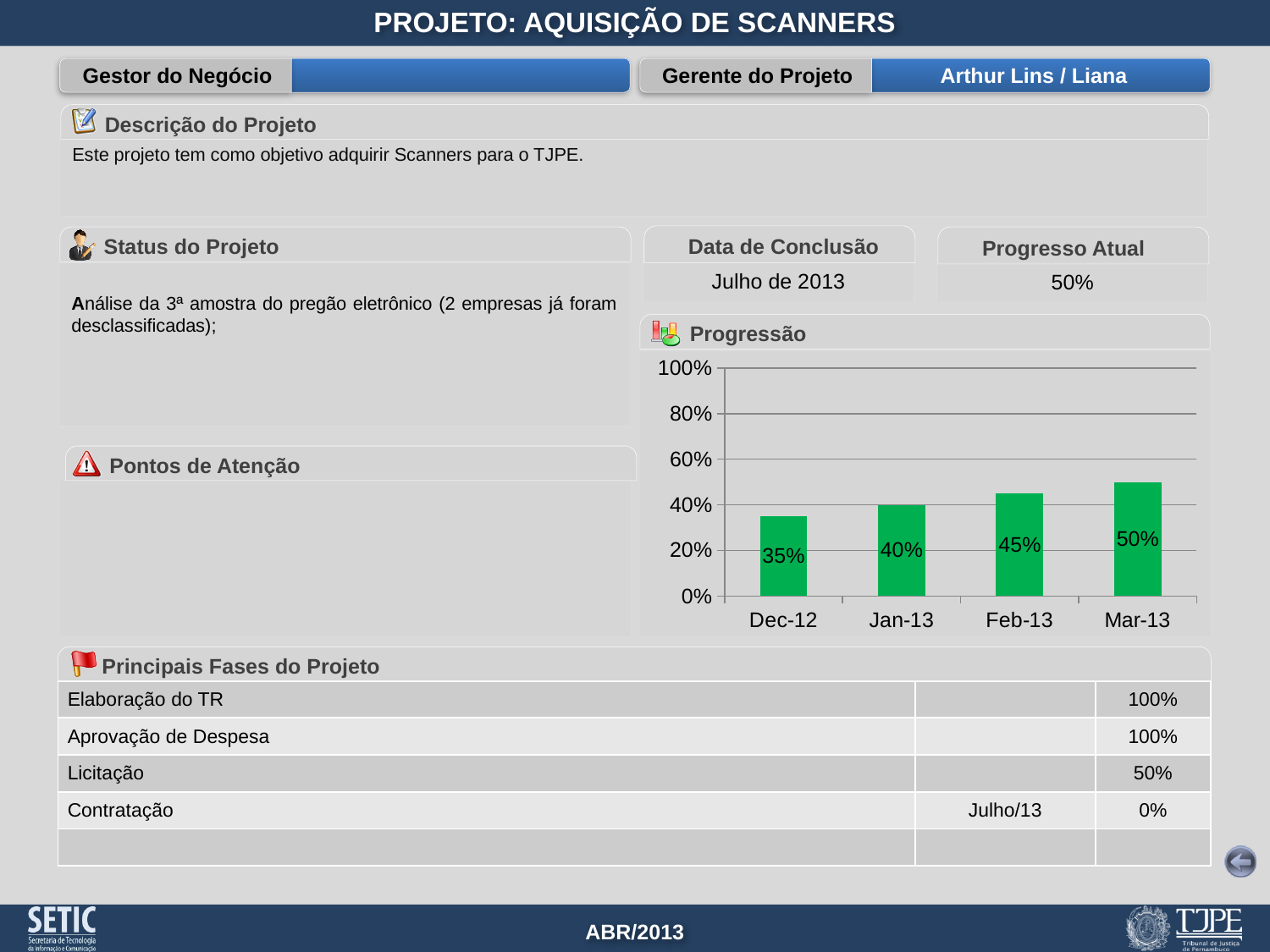
Do the values in the Progressão chart rise or fall from Dec-12 to Mar-13? rise Which month has the highest value in the Progressão chart? Mar-13 What kind of chart is the Progressão chart? bar chart What is the value for Feb-13 in the Progressão chart? 45% What is the value for Jan-13 in the Progressão chart? 40% How many months are shown on the x axis of the Progressão chart? 4 What is the value for Mar-13 in the Progressão chart? 50% What is the value for Dec-12 in the Progressão chart? 35% Is the value for Mar-13 in the Progressão chart greater or less than 60%? less Which month has the lowest value in the Progressão chart? Dec-12 Which is larger in the Progressão chart, the value for Jan-13 or the value for Feb-13? Feb-13 What is the difference between the values for Mar-13 and Dec-12 in the Progressão chart? 15%